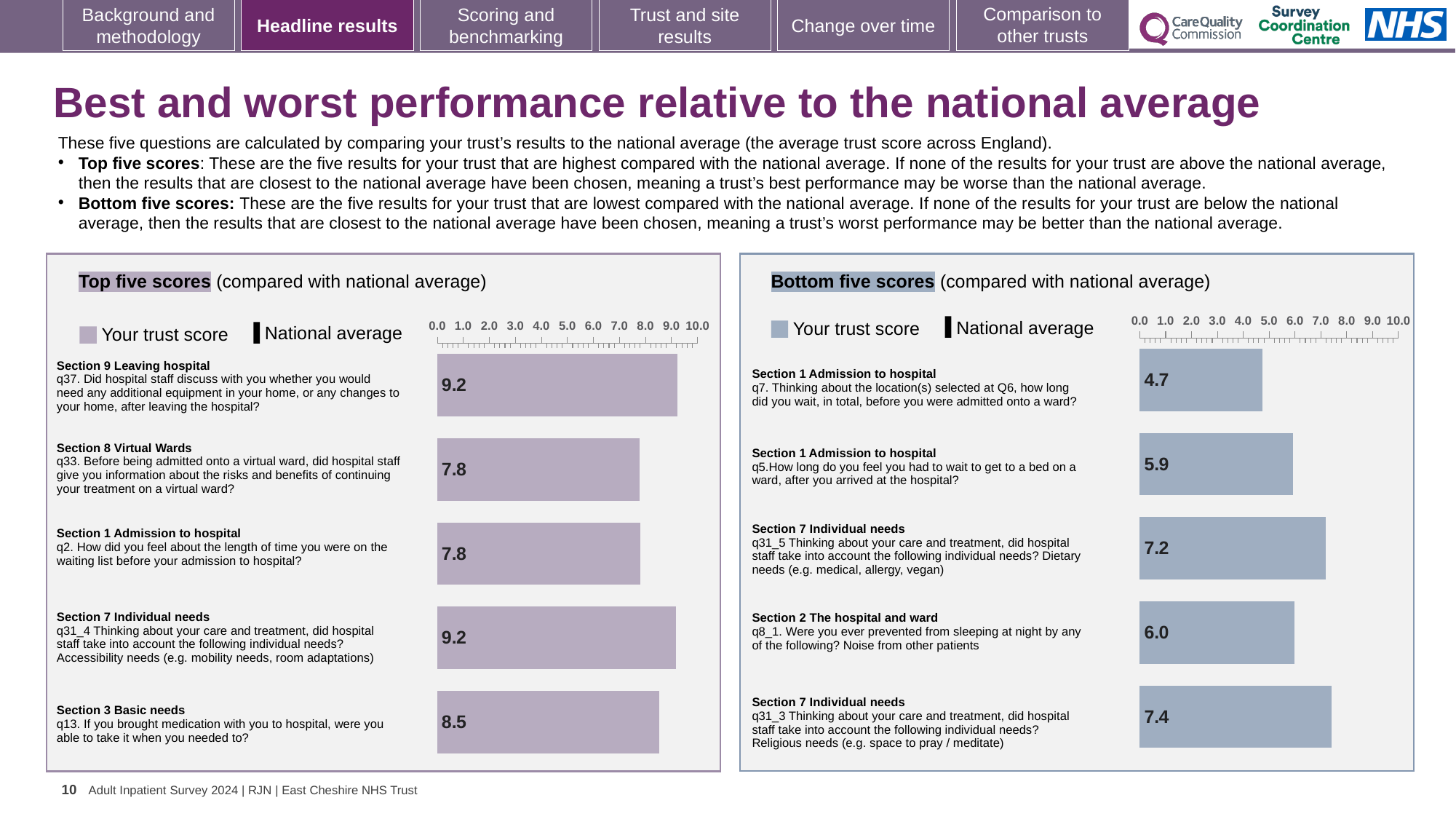
In the Bottom five scores chart, which question has the highest trust score? q31_3 (Section 7 Individual needs) What kind of chart is the Bottom five scores chart? Bar chart In the Bottom five scores chart, what is the trust score for q8_1 (Section 2 The hospital and ward)? 6.0 How many bars are shown in the Top five scores chart? 5 In the Bottom five scores chart, which question has the lowest trust score? q7 (Section 1 Admission to hospital) In the Top five scores chart, what is the trust score for q37 (Section 9 Leaving hospital)? 9.2 In the Top five scores chart, what is the trust score for q13 (Section 3 Basic needs)? 8.5 In the Bottom five scores chart, which has the larger trust score, q31_5 or q5? q31_5 In the Bottom five scores chart, what is the trust score for q7 (Section 1 Admission to hospital)? 4.7 In the Top five scores chart, what is the lowest trust score shown? 7.8 In the Bottom five scores chart, what is the difference between the trust scores for q31_3 and q7? 2.7 In the Top five scores chart, what is the difference between the trust scores for q37 and q13? 0.7